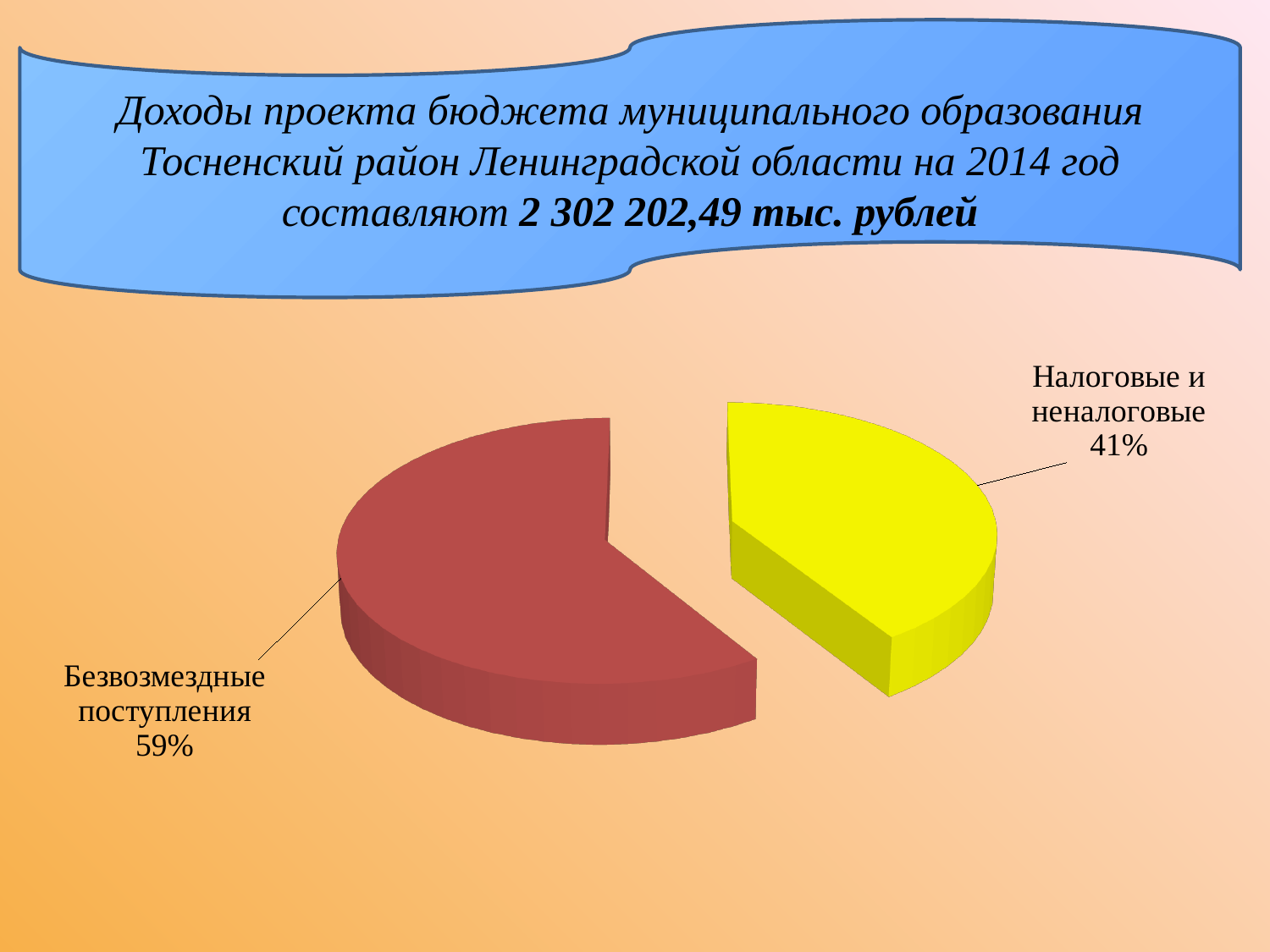
Which is larger: "Безвозмездные поступления" or "Налоговые и неналоговые"? Безвозмездные поступления Which slice of the pie is the smallest? Налоговые и неналоговые Is the share for "Безвозмездные поступления" greater or less than 50%? greater What share of the pie does "Налоговые и неналоговые" represent? 41% Which slice of the pie is the largest? Безвозмездные поступления How many slices does the pie chart have? 2 What colour is the slice for "Безвозмездные поступления"? Red Is the share for "Налоговые и неналоговые" greater or less than 50%? less What is the difference in percentage points between "Безвозмездные поступления" and "Налоговые и неналоговые"? 18 What share of the pie does "Безвозмездные поступления" represent? 59% What kind of chart is shown on the slide? Pie chart What colour is the slice for "Налоговые и неналоговые"? Yellow